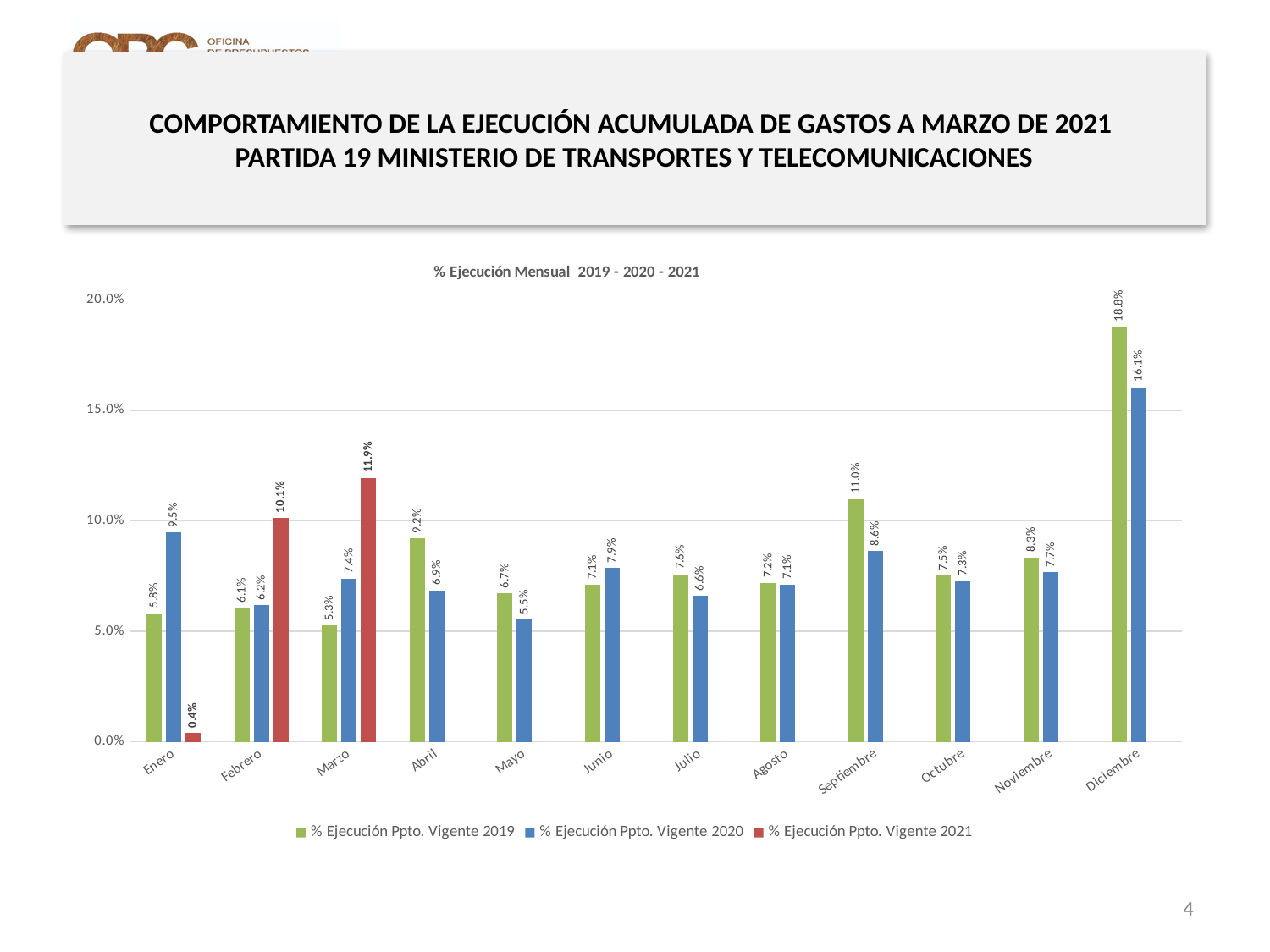
What kind of chart is shown on the slide? Bar chart What is the value for % Ejecución Ppto. Vigente 2021 in Marzo? 11.9% What is the difference between the 2019 and 2020 values in Diciembre? 2.7% Which month has the lowest value for % Ejecución Ppto. Vigente 2020? Mayo What is the title of the chart? % Ejecución Mensual 2019 - 2020 - 2021 How many months are shown on the x axis? 12 In Abril, which series is larger: % Ejecución Ppto. Vigente 2019 or % Ejecución Ppto. Vigente 2020? % Ejecución Ppto. Vigente 2019 What is the value for % Ejecución Ppto. Vigente 2019 in Septiembre? 11.0% Which month has the highest value for % Ejecución Ppto. Vigente 2019? Diciembre Is the value for % Ejecución Ppto. Vigente 2021 in Febrero greater or less than 10.0%? greater What is the value for % Ejecución Ppto. Vigente 2020 in Enero? 9.5% How many series does the legend list? 3